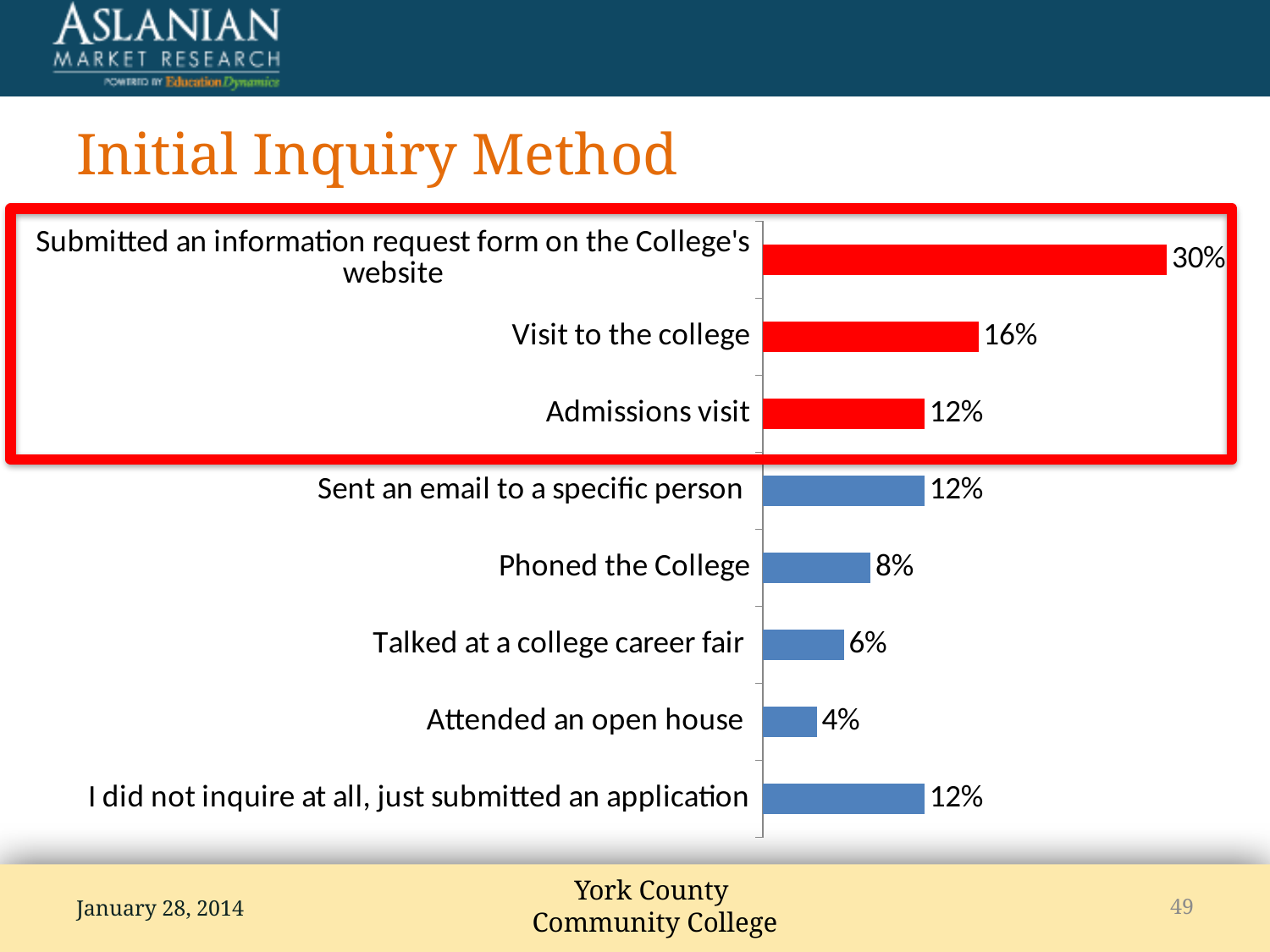
Which initial inquiry method has the lowest percentage? Attended an open house What is the difference between 'Submitted an information request form on the College's website' and 'Visit to the college'? 14% What kind of chart is shown on the slide? Bar chart What percentage of respondents submitted an information request form on the College's website? 30% Which initial inquiry method has the highest percentage? Submitted an information request form on the College's website What percentage of respondents phoned the College? 8% How many inquiry methods are shown in the chart? 8 What is the value for 'Visit to the college'? 16% What is the title of the slide? Initial Inquiry Method Which is larger: 'Phoned the College' or 'Talked at a college career fair'? Phoned the College What is the value for 'Attended an open house'? 4% How many bars are coloured red and enclosed in the red box? 3